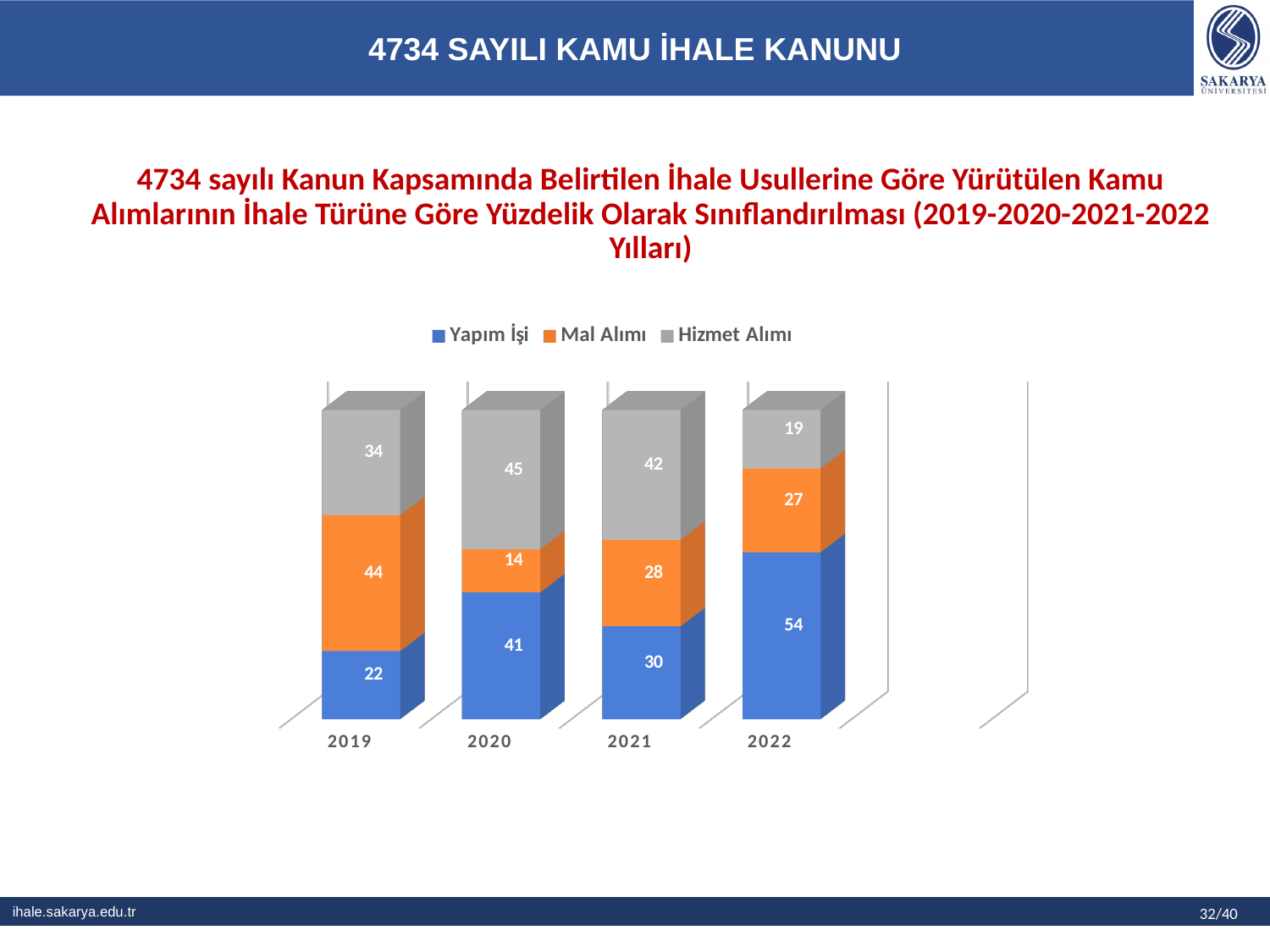
Which is larger, Yapım İşi in 2020 or Yapım İşi in 2021? Yapım İşi in 2020 What is the value for Hizmet Alımı in 2020? 45 Does the value for Hizmet Alımı rise or fall from 2021 to 2022? Fall How many series does the legend list? 3 How many years are shown on the x axis? 4 What kind of chart is shown on the slide? Stacked bar chart What is the value for Yapım İşi in 2022? 54 What is the value for Mal Alımı in 2019? 44 Which year has the highest value for Yapım İşi? 2022 What is the total of the stacked bar for 2019? 100 What is the difference between the Hizmet Alımı values for 2021 and 2022? 23 Which year has the lowest value for Mal Alımı? 2020